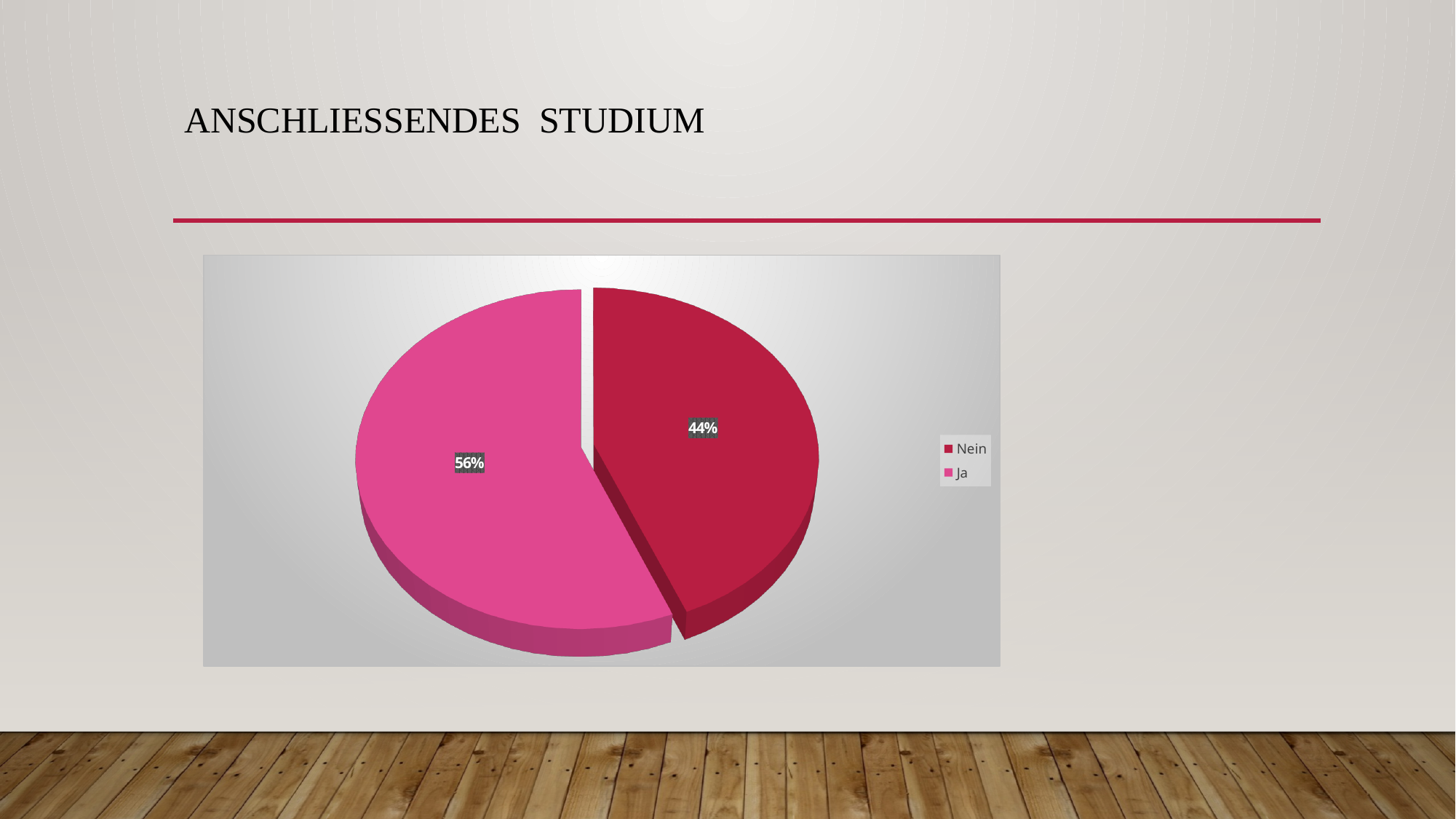
How many slices does the pie chart have? 2 Which slice is the smallest in the pie chart? Nein What is the difference in percentage points between the "Ja" and "Nein" slices? 12 What is the title of the slide containing the pie chart? ANSCHLIESSENDES STUDIUM How many entries does the legend list? 2 What share of the pie does the "Ja" slice represent? 56% Which slice is larger, "Ja" or "Nein"? Ja What kind of chart is shown on the slide? pie chart What share of the pie does the "Nein" slice represent? 44% Which legend entry is shown in the darker red colour? Nein Which slice is the largest in the pie chart? Ja